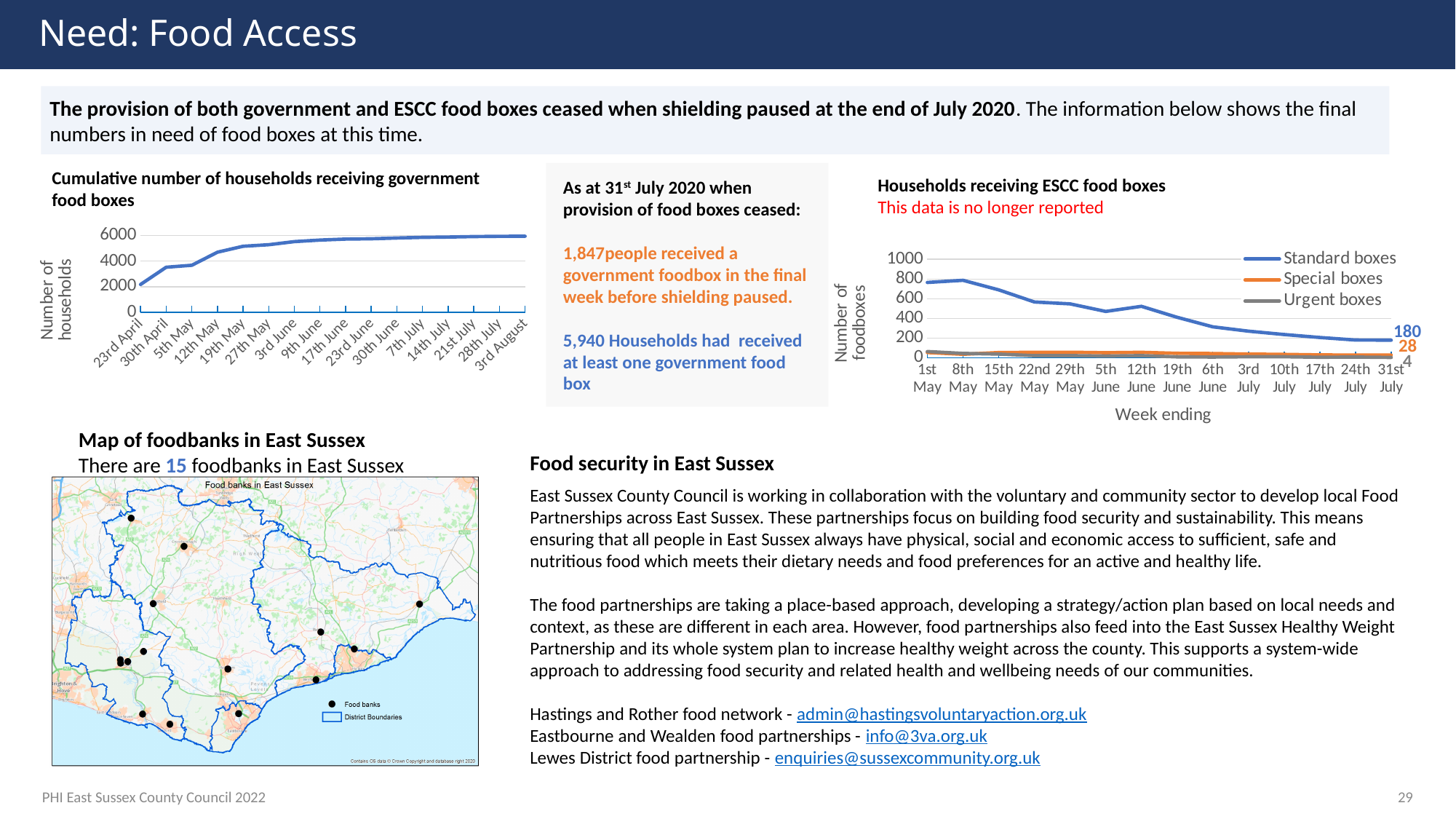
How many series does the legend of the 'Households receiving ESCC food boxes' chart list? 3 In the 'Households receiving ESCC food boxes' chart, what is the value for Urgent boxes at the week ending 31st July? 4 How many dates are shown on the x axis of the 'Cumulative number of households receiving government food boxes' chart? 16 In the 'Cumulative number of households receiving government food boxes' chart, is the value for 3rd August greater or less than 4000? greater In the 'Households receiving ESCC food boxes' chart, what is the difference between Standard boxes and Special boxes at the week ending 31st July? 152 What kind of chart is the 'Cumulative number of households receiving government food boxes' chart? line chart In the 'Households receiving ESCC food boxes' chart, do the values for Standard boxes rise or fall from 1st May to 31st July? fall What is the x-axis title of the 'Households receiving ESCC food boxes' chart? Week ending In the 'Cumulative number of households receiving government food boxes' chart, do the values rise or fall from 23rd April to 3rd August? rise In the 'Cumulative number of households receiving government food boxes' chart, is the value for 23rd April greater or less than 4000? less In the 'Households receiving ESCC food boxes' chart, what is the value for Standard boxes at the week ending 31st July? 180 In the 'Households receiving ESCC food boxes' chart, what is the value for Special boxes at the week ending 31st July? 28